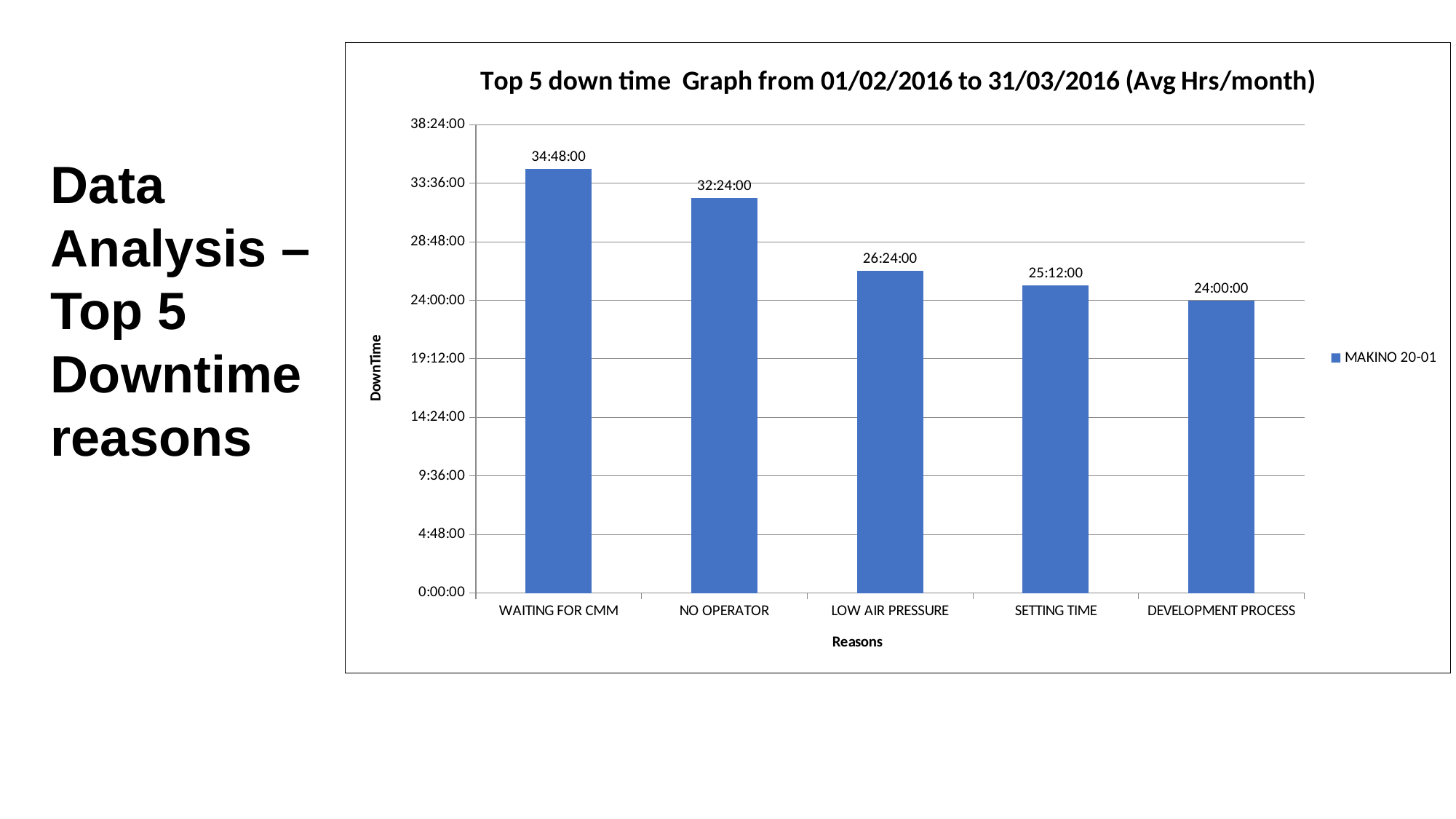
What is the difference between the values for WAITING FOR CMM and NO OPERATOR? 2:24:00 What is the value for LOW AIR PRESSURE? 26:24:00 How many series does the legend list? 1 What is the value for DEVELOPMENT PROCESS? 24:00:00 How many reasons are shown on the x axis? 5 Which is larger, the value for NO OPERATOR or the value for SETTING TIME? NO OPERATOR Is the value for NO OPERATOR greater or less than 28:48:00? greater Which reason has the highest downtime? WAITING FOR CMM What is the value for WAITING FOR CMM? 34:48:00 What is the difference between the values for LOW AIR PRESSURE and SETTING TIME? 1:12:00 Which reason has the lowest downtime? DEVELOPMENT PROCESS What kind of chart is shown on the slide? bar chart